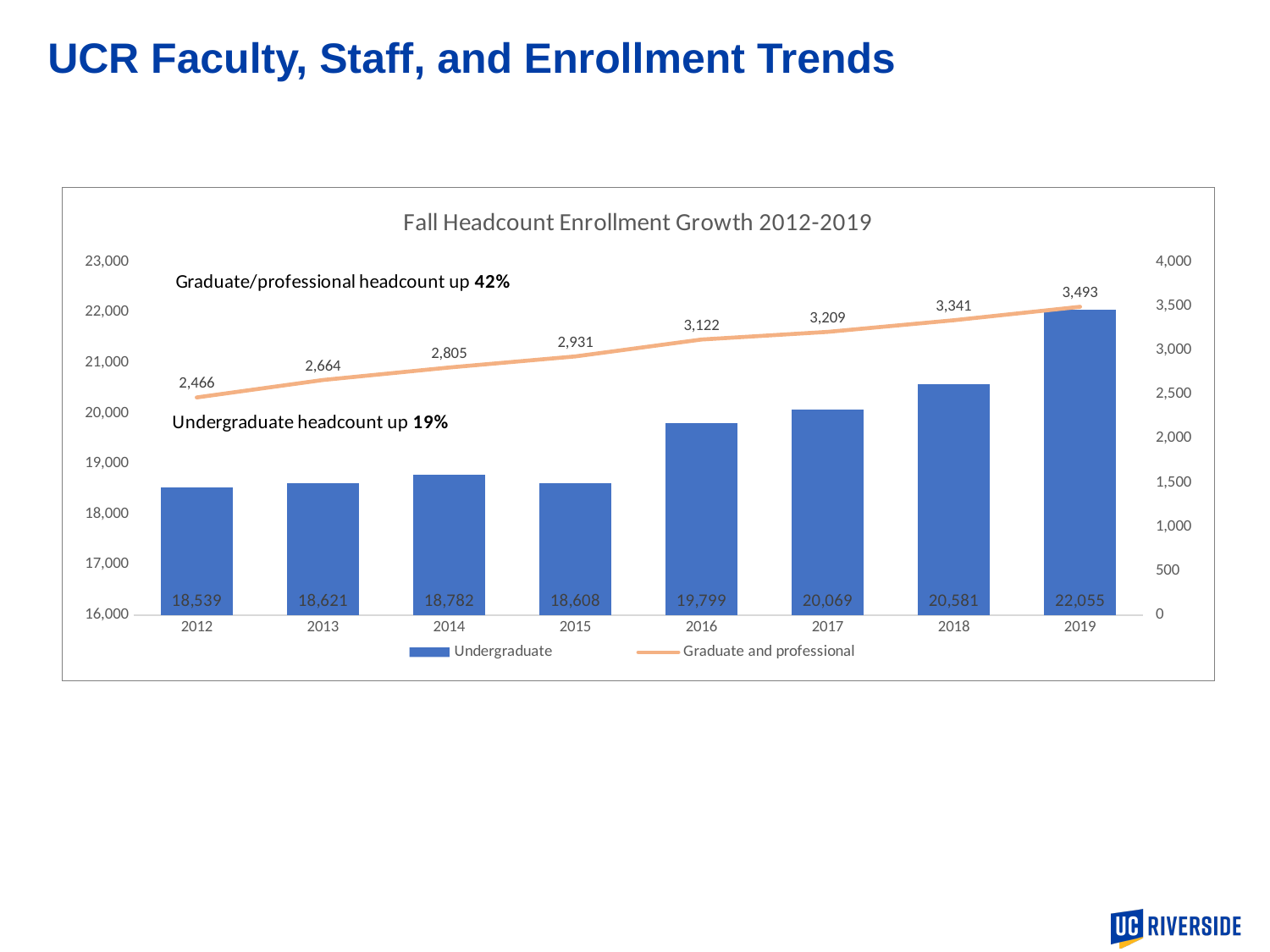
What is the Graduate and professional headcount for 2014? 2,805 What is the title of the chart? Fall Headcount Enrollment Growth 2012-2019 How many series does the legend list? 2 How many years are shown on the x axis? 8 Which is larger, the Undergraduate headcount in 2014 or in 2015? 2014 What is the Undergraduate headcount for 2016? 19,799 Which year has the highest Undergraduate headcount? 2019 Which year has the lowest Undergraduate headcount? 2012 What is the difference between the Graduate and professional headcount in 2019 and in 2018? 152 Does the Graduate and professional headcount rise or fall from 2012 to 2019? Rise What is the difference between the Undergraduate headcount in 2019 and in 2012? 3,516 What kind of chart is used for the Undergraduate series? Bar chart